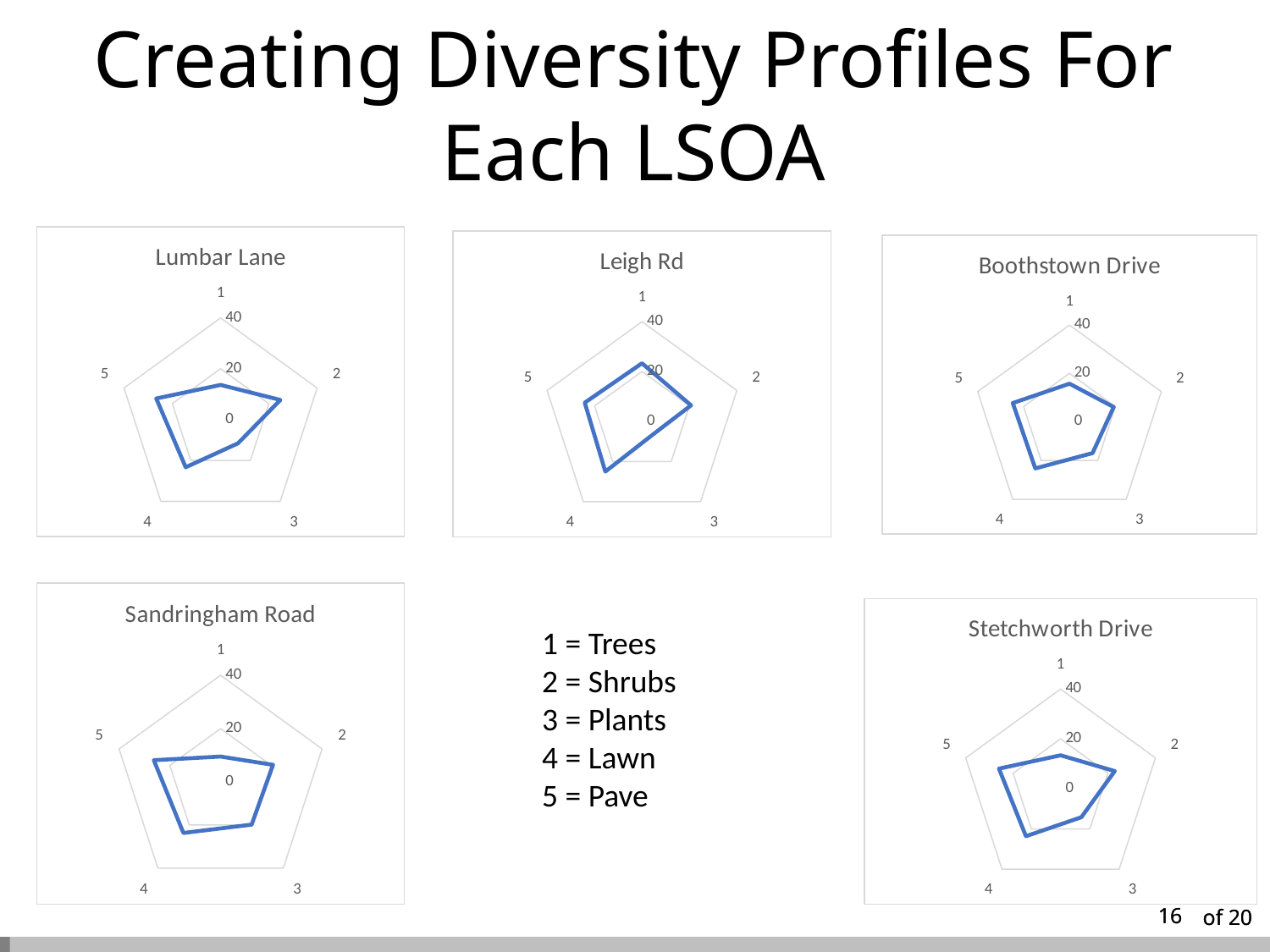
According to the key on the slide, what does axis 5 represent? Pave What kind of chart is used for Lumbar Lane? radar chart In the Sandringham Road chart, is the value for axis 1 greater or less than 20? less What is the highest value shown on the axis scale of the Stetchworth Drive chart? 40 In the Lumbar Lane chart, is the value for axis 3 greater or less than 20? less In the Leigh Rd chart, which axis has the lowest value? 3 In the Stetchworth Drive chart, is the value for axis 1 greater or less than 20? less In the Sandringham Road chart, which axis has the lowest value? 1 How many charts are shown on the slide? 5 How many axes (categories) does the Leigh Rd chart have? 5